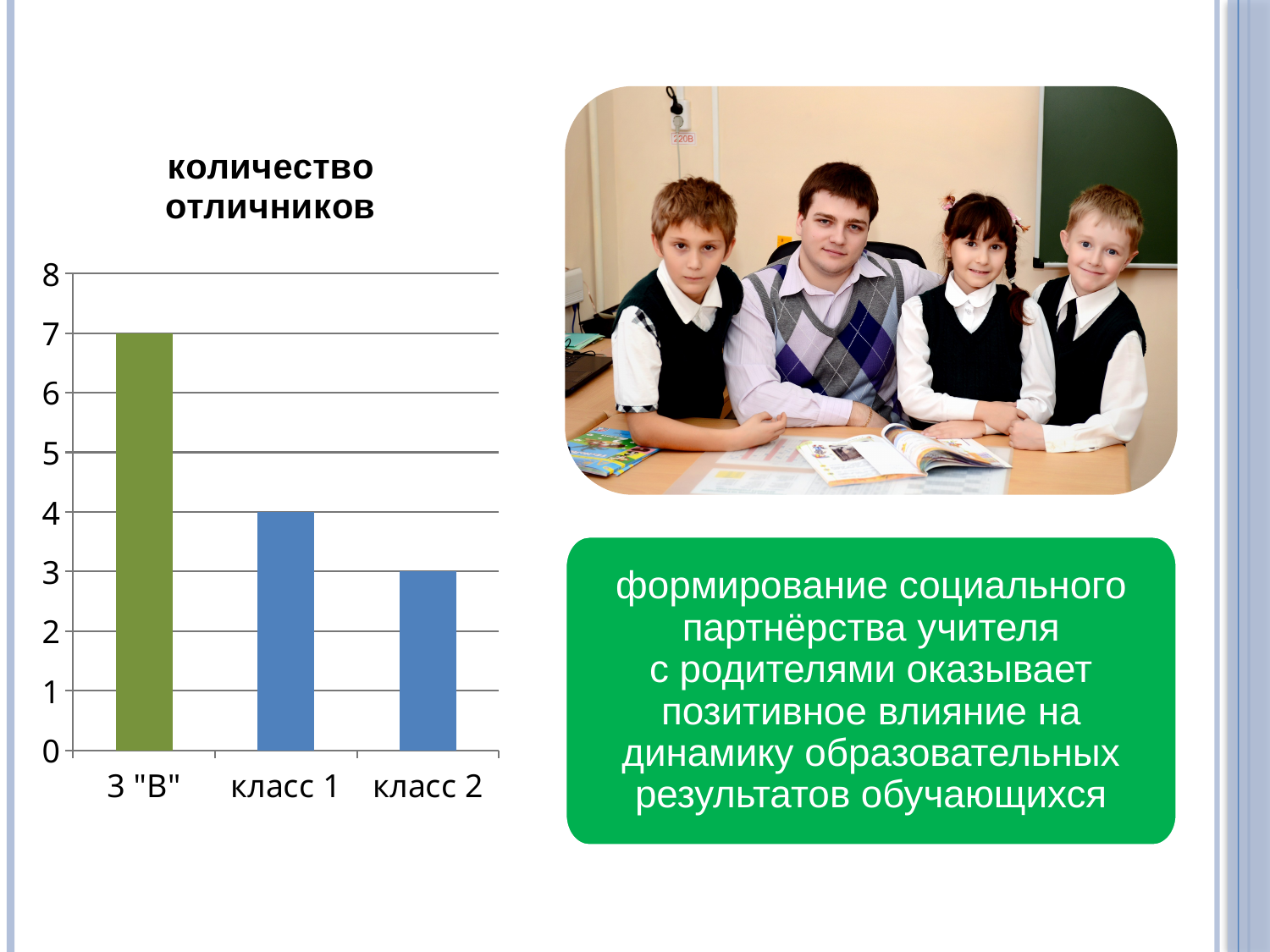
What is the value for 3 "В" in the chart? 7 Which category has the highest value in the chart? 3 "В" What is the value for класс 1 in the chart? 4 Is the value for 3 "В" greater or less than 5? greater What kind of chart is shown on the slide? bar chart What is the difference between the values for 3 "В" and класс 1? 3 What is the value for класс 2 in the chart? 3 Which category has the lowest value in the chart? класс 2 How many categories are shown in the chart? 3 What is the title of the chart? количество отличников What is the difference between the values for класс 1 and класс 2? 1 Which is larger, the value for 3 "В" or the value for класс 2? 3 "В"